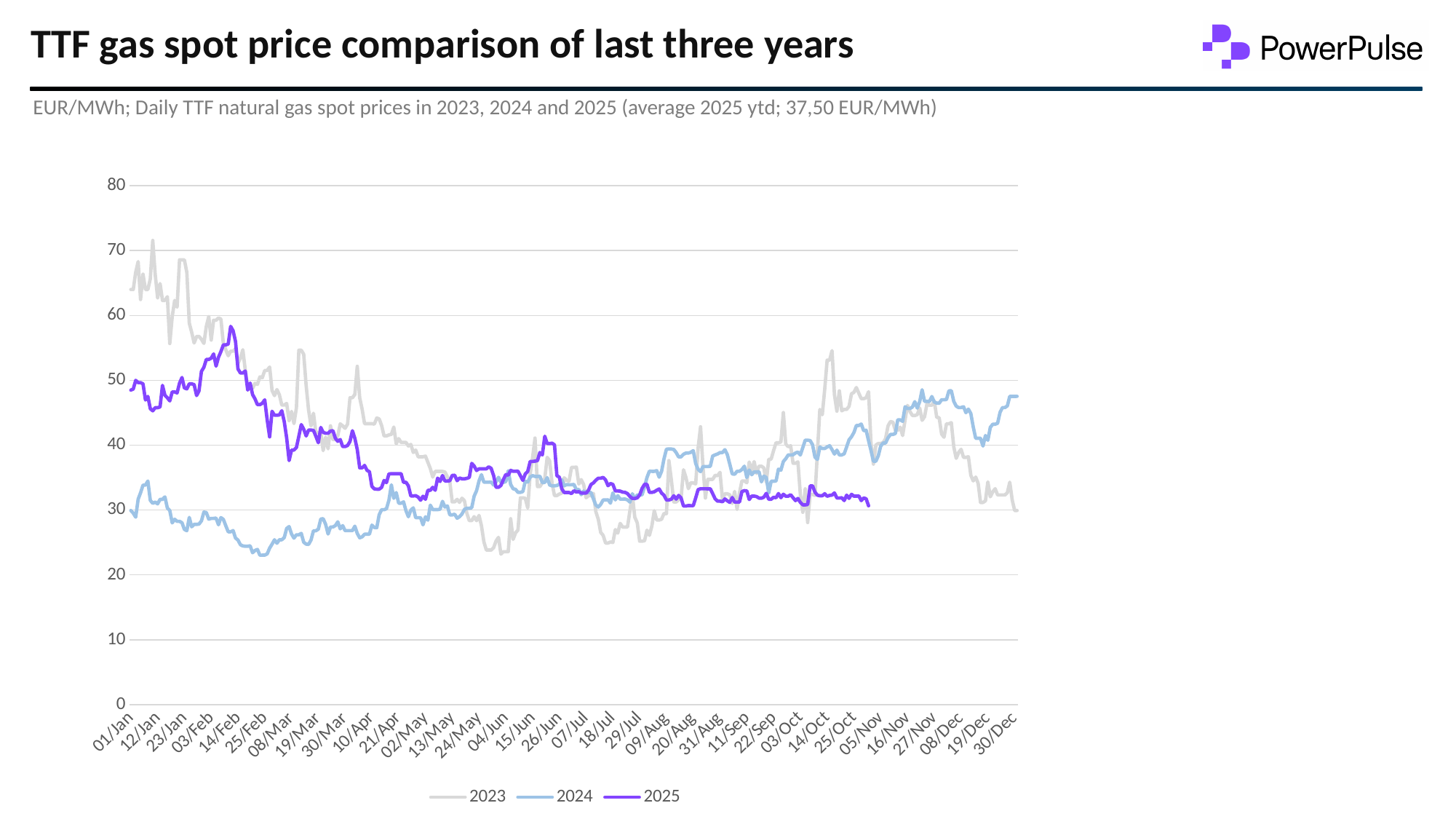
At 01/Jan, which series has the higher value, 2023 or 2024? 2023 Is the 2024 value at 01/Jan greater or less than 40? less Which series has the highest value at 01/Jan? 2023 Which years are listed in the chart legend? 2023, 2024 and 2025 Is the 2024 value at 30/Dec greater or less than 40? greater How many series does the legend list? 3 What is the average 2025 year-to-date TTF spot price stated on the slide? 37,50 EUR/MWh Is the 2023 value at 01/Jan greater or less than 60? greater Does the 2025 line rise or fall between mid-February and April? fall What kind of chart is shown on the slide? line chart